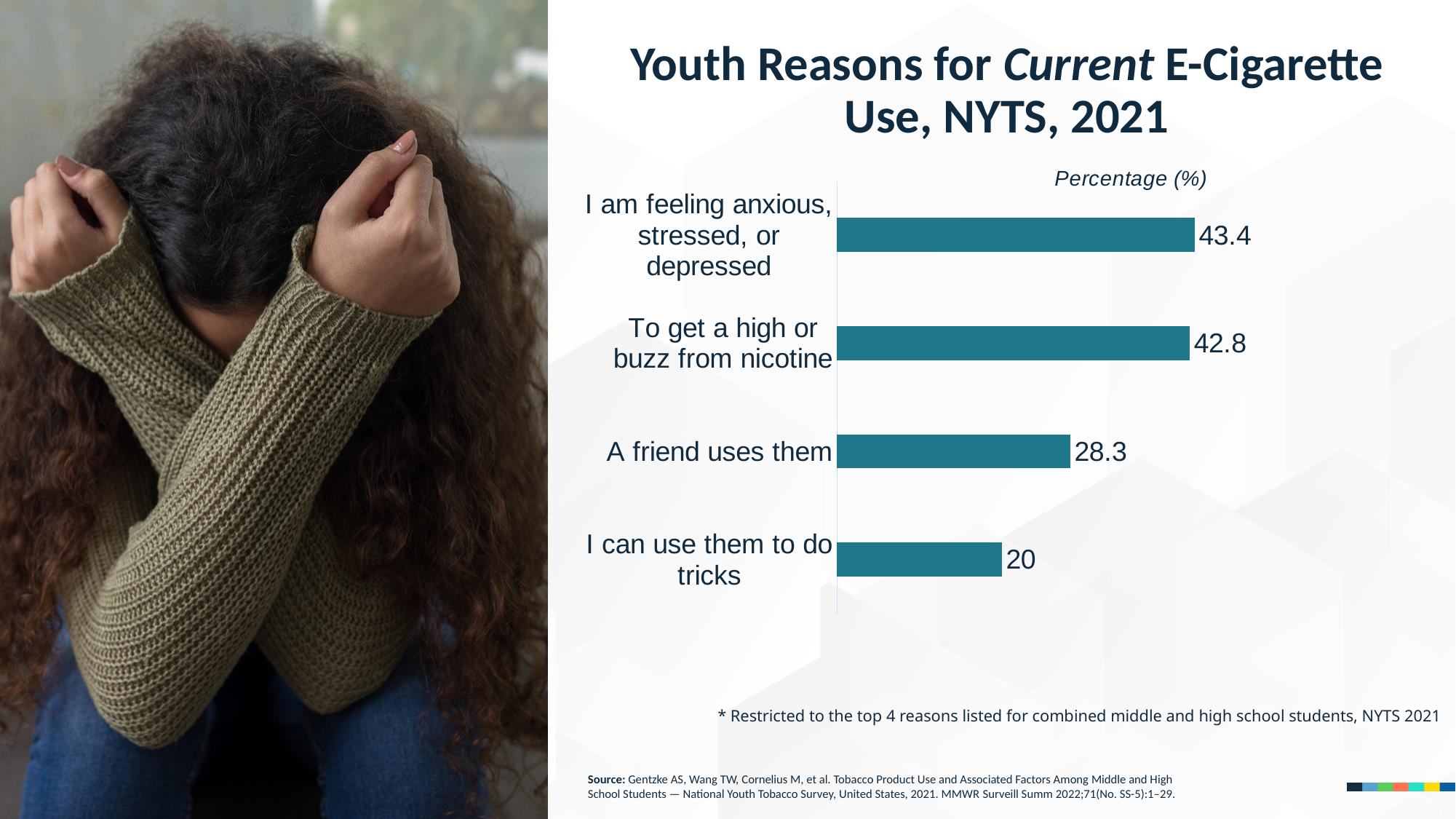
What is the difference between the values for "I am feeling anxious, stressed, or depressed" and "To get a high or buzz from nicotine"? 0.6 How many reasons are shown in the chart? 4 What is the difference between the values for "A friend uses them" and "I can use them to do tricks"? 8.3 What is the value shown for "To get a high or buzz from nicotine"? 42.8 What kind of chart is shown on the slide? Bar chart What is the title of the chart? Youth Reasons for Current E-Cigarette Use, NYTS, 2021 Which reason has the lowest percentage? I can use them to do tricks What percentage of youth cited "I am feeling anxious, stressed, or depressed" as a reason for current e-cigarette use? 43.4 What is the value for "I can use them to do tricks"? 20 What percentage is shown for "A friend uses them"? 28.3 Which reason has the highest percentage? I am feeling anxious, stressed, or depressed Which has a larger value: "A friend uses them" or "I can use them to do tricks"? A friend uses them